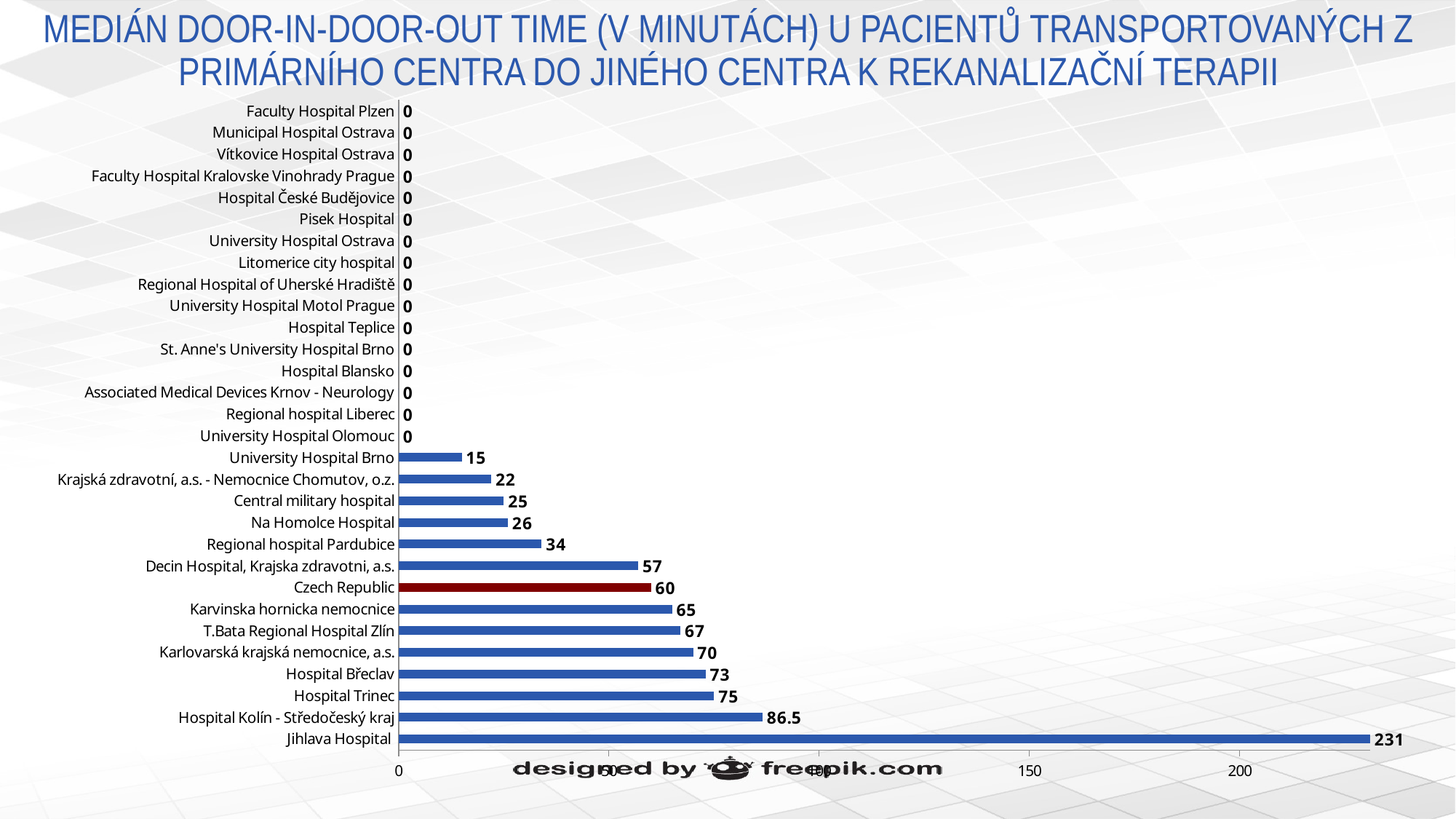
What type of chart is shown on the slide? Bar chart Which is larger, the value for Karvinska hornicka nemocnice or the value for Regional hospital Pardubice? Karvinska hornicka nemocnice What is the difference between the values for Jihlava Hospital and Czech Republic? 171 Is the value for Jihlava Hospital greater or less than 200? greater What is the median door-in-door-out time for Jihlava Hospital? 231 What is the difference between the values for Hospital Trinec and Hospital Břeclav? 2 Which hospital has the highest median door-in-door-out time? Jihlava Hospital How many hospitals/categories are listed on the chart? 30 What is the value for University Hospital Brno? 15 What is the value for Hospital Kolín - Středočeský kraj? 86.5 What is the value shown for Czech Republic? 60 Which bar is shown in a different colour (dark red) from the others? Czech Republic